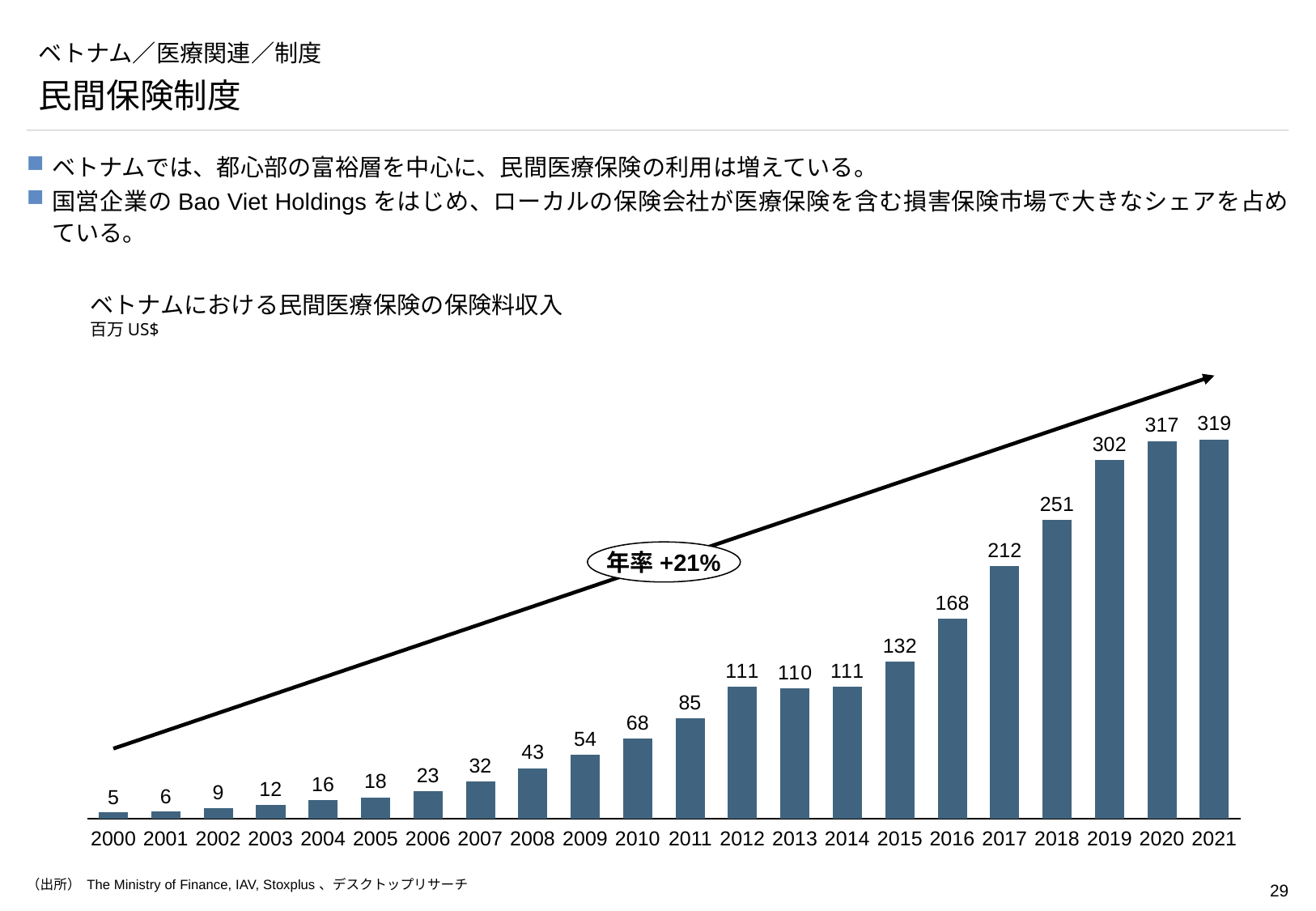
Which year has the highest value? 2021 What is the value for 2019? 302 What is the value for 2015? 132 Which is larger, the value for 2012 or the value for 2013? 2012 How many years are shown on the x axis? 22 What kind of chart is this? bar chart Do the values generally rise or fall from 2000 to 2021? rise Which year has the lowest value? 2000 What is the difference between the values for 2021 and 2020? 2 What annual growth rate is shown in the oval label on the chart? 年率 +21% What is the difference between the values for 2018 and 2017? 39 What is the value for 2000? 5